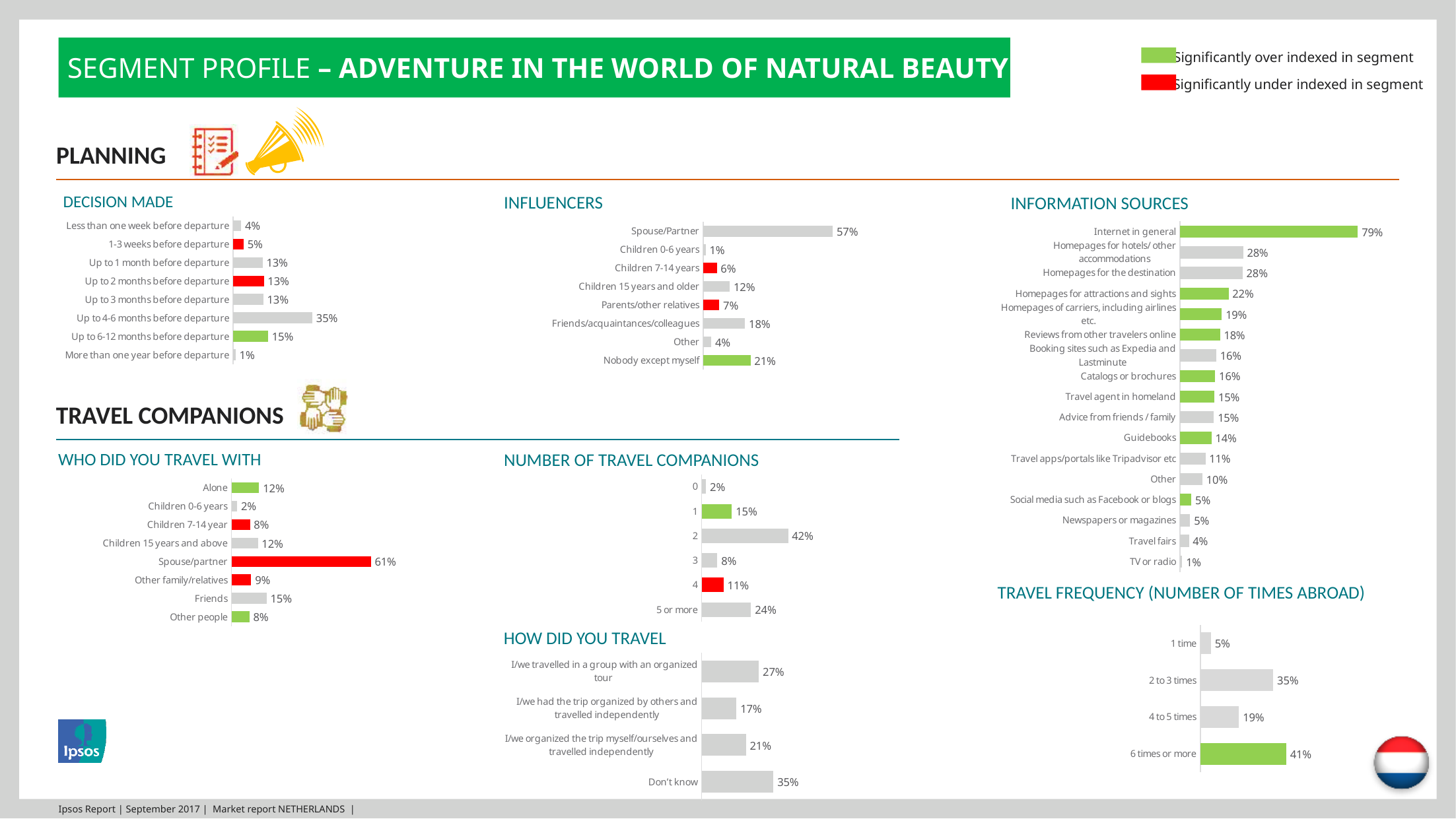
What type of chart is the INFLUENCERS chart? Bar chart In the DECISION MADE chart, what is the value for 'Up to 4-6 months before departure'? 35% According to the legend at the top right, what does a green bar indicate? Significantly over indexed in segment In the INFORMATION SOURCES chart, what is the value for 'Internet in general'? 79% In the TRAVEL FREQUENCY (NUMBER OF TIMES ABROAD) chart, which category has the highest value? 6 times or more In the INFORMATION SOURCES chart, which category has the lowest value? TV or radio In the TRAVEL FREQUENCY (NUMBER OF TIMES ABROAD) chart, what is the difference between '6 times or more' and '2 to 3 times'? 6% In the HOW DID YOU TRAVEL chart, what is the value for 'Don't know'? 35% In the WHO DID YOU TRAVEL WITH chart, what is the difference between 'Spouse/partner' and 'Friends'? 46% In the INFLUENCERS chart, which category has the highest value? Spouse/Partner In the NUMBER OF TRAVEL COMPANIONS chart, which is larger: the value for '2' or the value for '5 or more'? 2 In the NUMBER OF TRAVEL COMPANIONS chart, how many categories are shown? 6